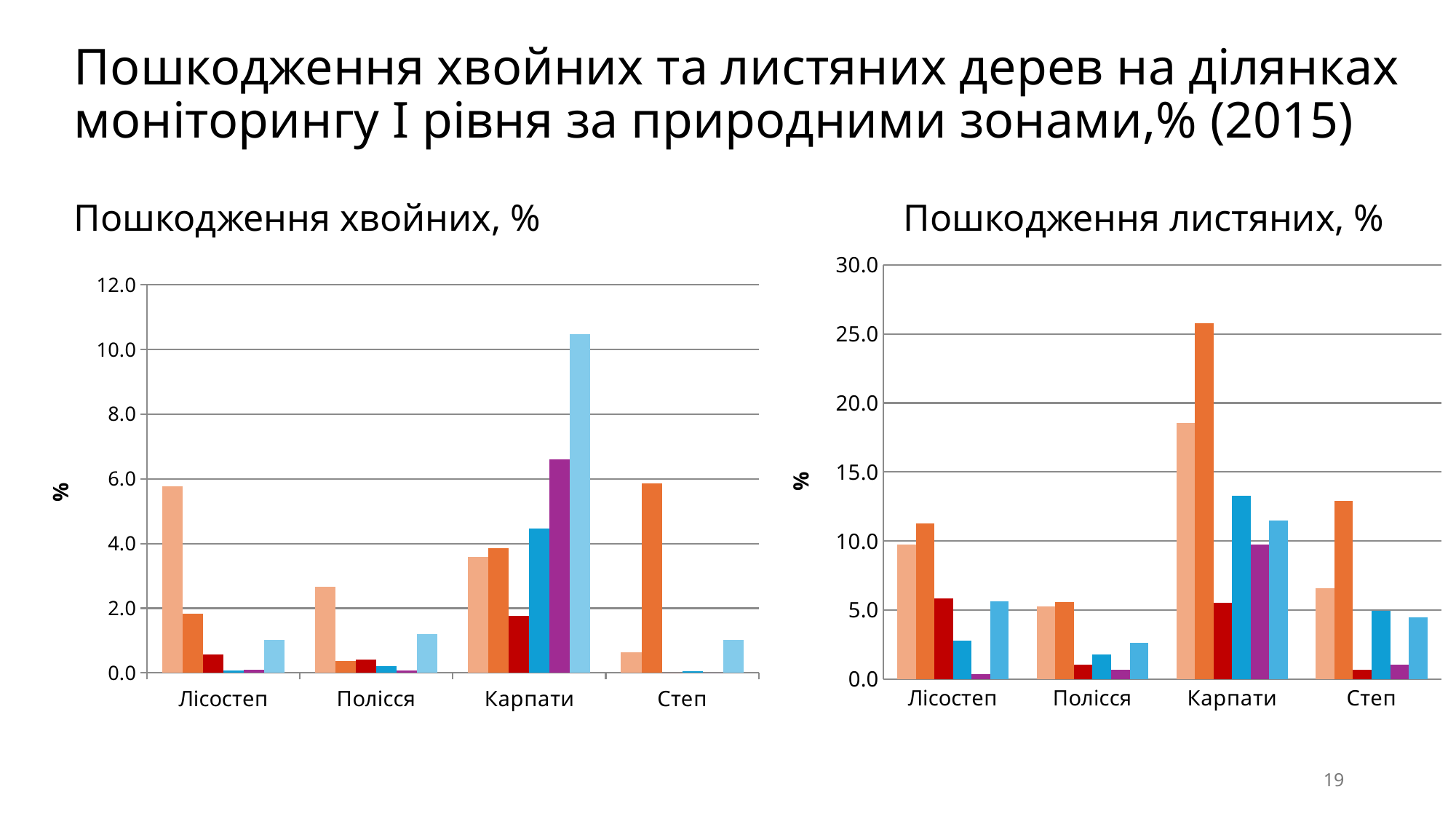
In the right chart "Пошкодження листяних, %", which category contains the tallest bar? Карпати In the left chart "Пошкодження хвойних, %", which category has the taller tallest bar: Карпати or Степ? Карпати In the right chart "Пошкодження листяних, %", is the tallest bar for Карпати greater or less than 25.0? greater How many categories are shown on the x axis of the right chart "Пошкодження листяних, %"? 4 In the left chart "Пошкодження хвойних, %", is the tallest bar for Полісся greater or less than 4.0? less In the left chart "Пошкодження хвойних, %", is the tallest bar for Карпати greater or less than 10.0? greater What kind of chart is the left chart titled "Пошкодження хвойних, %"? bar chart What is the y-axis label of the left chart "Пошкодження хвойних, %"? % What is the highest tick value shown on the y axis of the right chart "Пошкодження листяних, %"? 30.0 In the left chart "Пошкодження хвойних, %", which category contains the tallest bar? Карпати